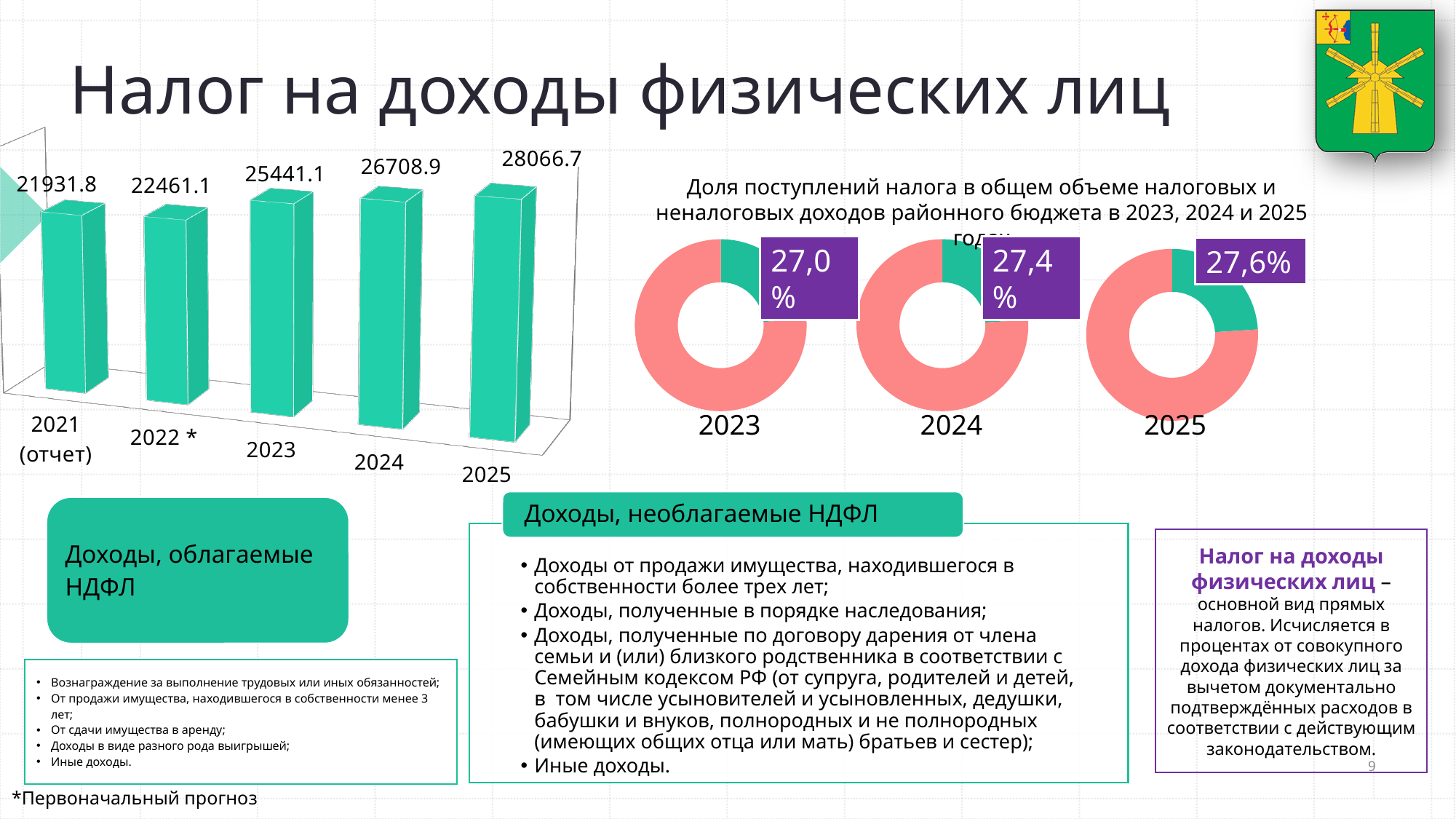
In the bar chart on the left, which year has the lowest value? 2021 (отчет) In the bar chart on the left, what is the difference between the values for 2025 and 2021 (отчет)? 6134.9 In the bar chart on the left, do the values rise or fall from 2021 to 2025? rise In the bar chart on the left, how many years are plotted? 5 In the donut charts on the right, what share is shown for 2024? 27,4% In the bar chart on the left, what is the value for 2023? 25441.1 In the bar chart on the left, what is the difference between the values for 2024 and 2023? 1267.8 In the donut charts on the right, what share is shown for 2025? 27,6% In the bar chart on the left, what is the value for 2025? 28066.7 In the bar chart on the left, what is the value for 2021 (отчет)? 21931.8 In the bar chart on the left, which year has the highest value? 2025 In the bar chart on the left, which is larger: the value for 2022 * or the value for 2023? 2023